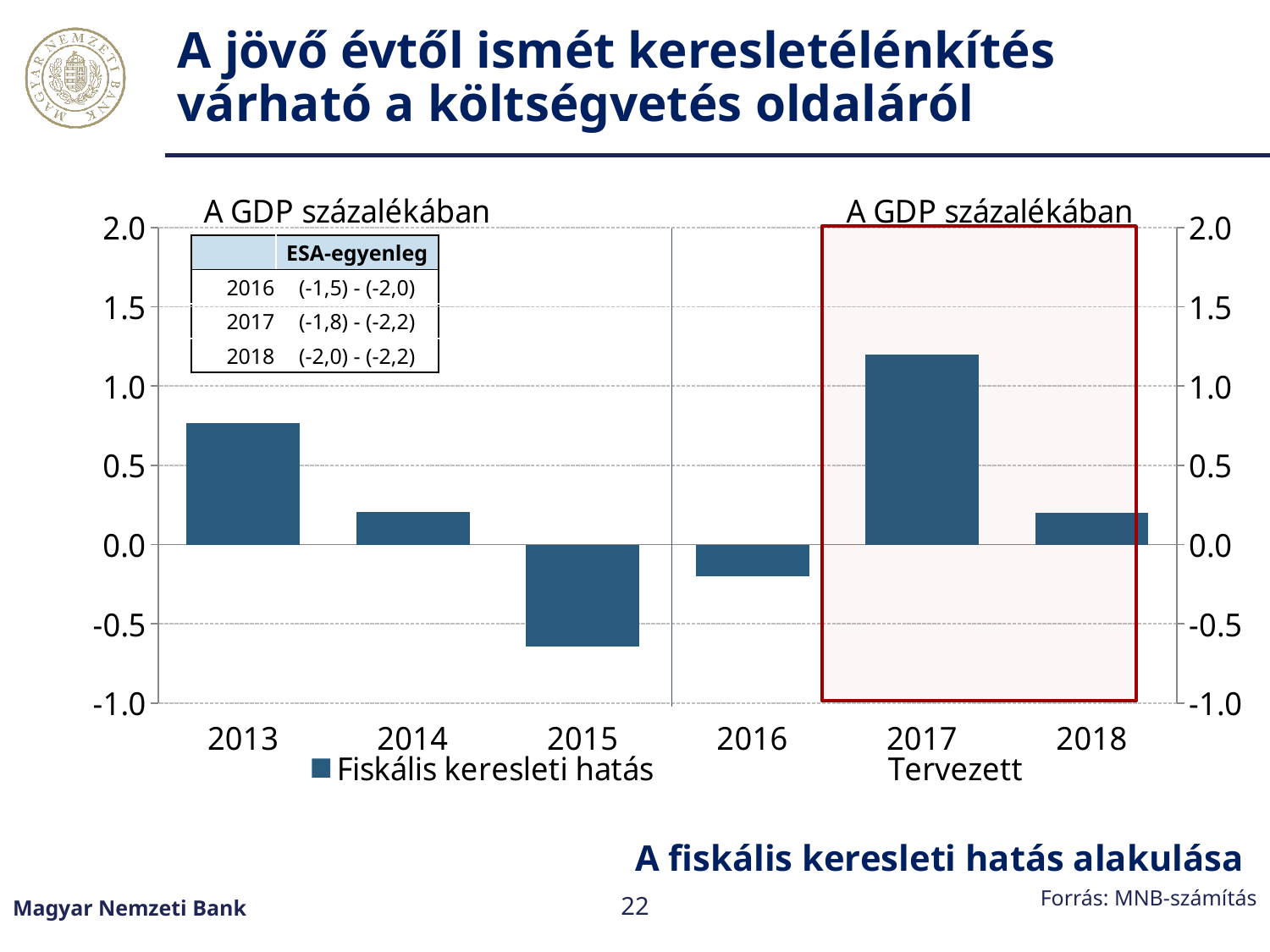
Is the value for 2014 greater or less than 0.5? less Is the value for 2017 greater or less than 1.0? greater Is the value for 2013 greater or less than 0.5? greater Which year has the highest fiscal demand effect (Fiskális keresleti hatás)? 2017 Do the values rise or fall from 2013 to 2015? fall What kind of chart is shown on the slide? bar chart Which year has the lowest fiscal demand effect (Fiskális keresleti hatás)? 2015 How many years are shown on the x axis of the chart? 6 Which year has the larger value, 2013 or 2014? 2013 How many series does the chart legend list? 2